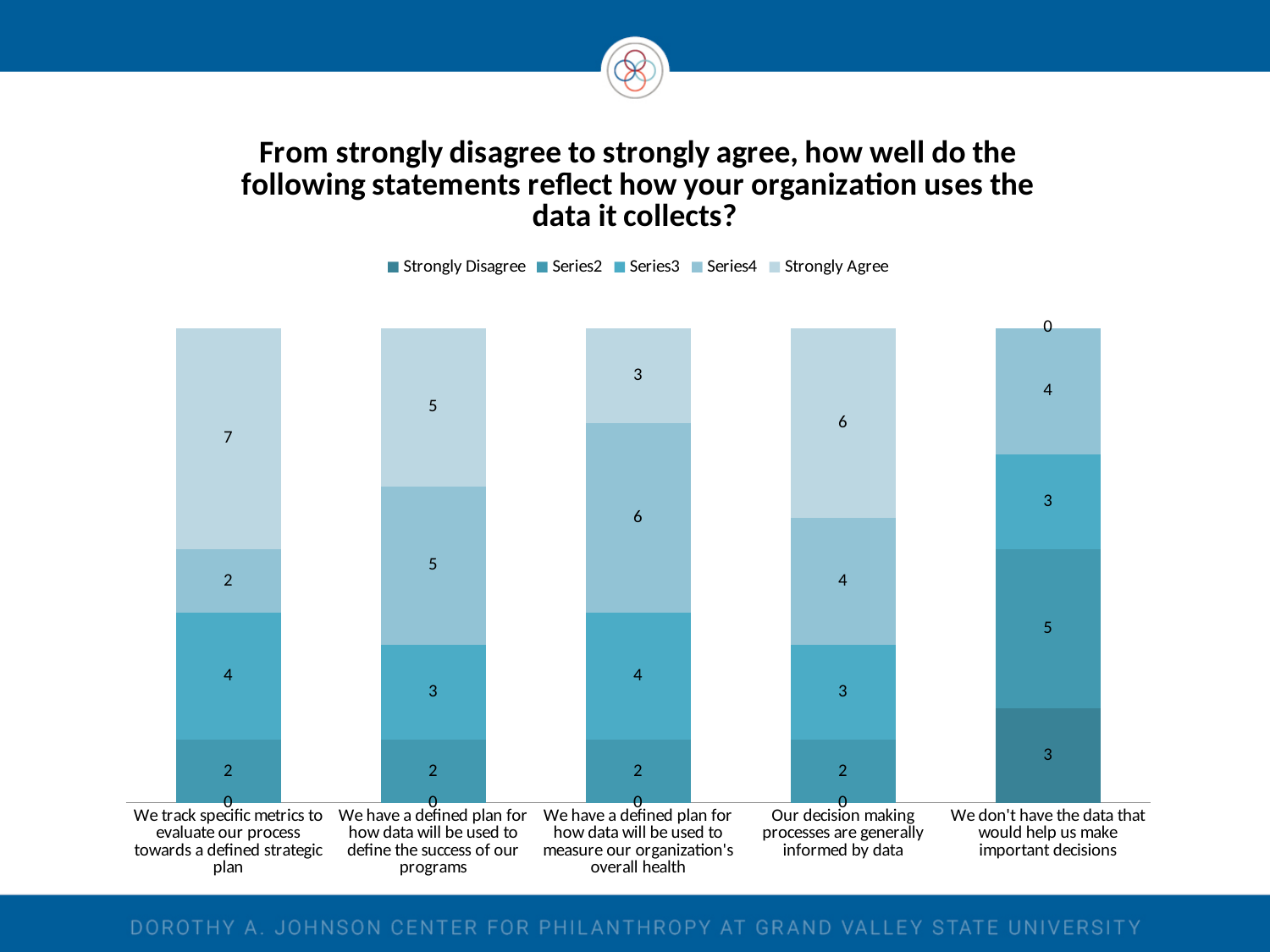
What is the difference between the Strongly Agree values for "Our decision making processes are generally informed by data" and "We have a defined plan for how data will be used to measure our organization's overall health"? 3 Which statement has the lowest Strongly Agree value? We don't have the data that would help us make important decisions What is the Strongly Agree value for "We track specific metrics to evaluate our process towards a defined strategic plan"? 7 Which statement has the highest Strongly Agree value? We track specific metrics to evaluate our process towards a defined strategic plan Which is larger: the Series3 value for "We track specific metrics to evaluate our process towards a defined strategic plan" or the Series3 value for "We have a defined plan for how data will be used to define the success of our programs"? We track specific metrics to evaluate our process towards a defined strategic plan What kind of chart is shown on the slide? Stacked bar chart How many statements (categories) are plotted on the x axis? 5 What is the Strongly Disagree value for "We don't have the data that would help us make important decisions"? 3 What is the first series listed in the legend? Strongly Disagree How many series does the legend list? 5 What is the Series4 value for "We have a defined plan for how data will be used to measure our organization's overall health"? 6 What is the total of the stacked bar for "Our decision making processes are generally informed by data"? 15